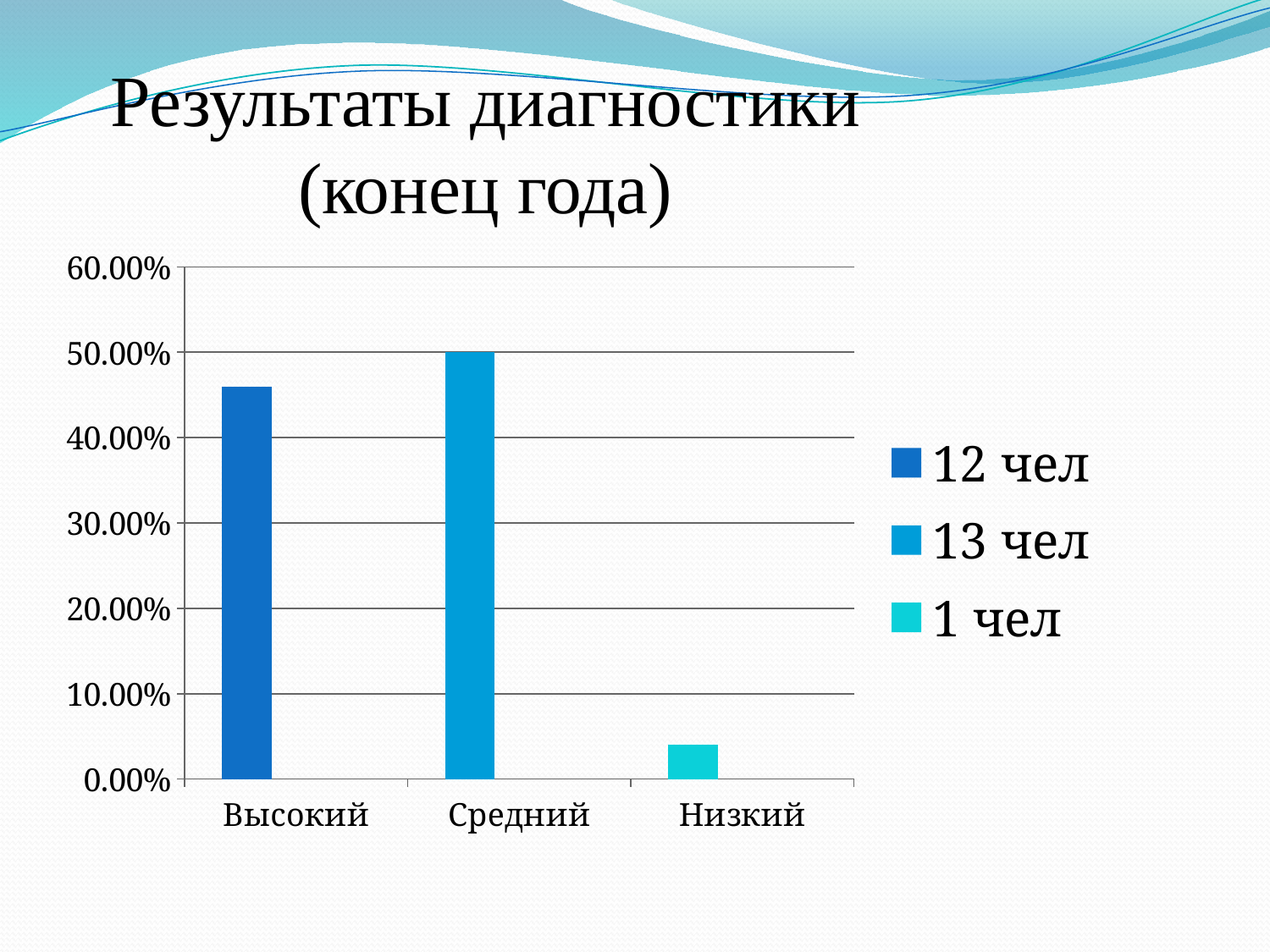
Is the value for Низкий greater or less than 10.00%? less How many entries does the chart's legend list? 3 How many categories are shown on the x axis of the chart? 3 Is the value for Высокий greater or less than 50.00%? less Which is larger, the value for Высокий or the value for Низкий? Высокий Which category has the highest bar in the chart? Средний What is the value for Средний in the chart? 50.00% Which legend entry corresponds to the Низкий bar? 1 чел Is the value for Высокий greater or less than 40.00%? greater Which category has the lowest bar in the chart? Низкий What kind of chart is shown on the slide? bar chart What is the title of the slide containing the chart? Результаты диагностики (конец года)